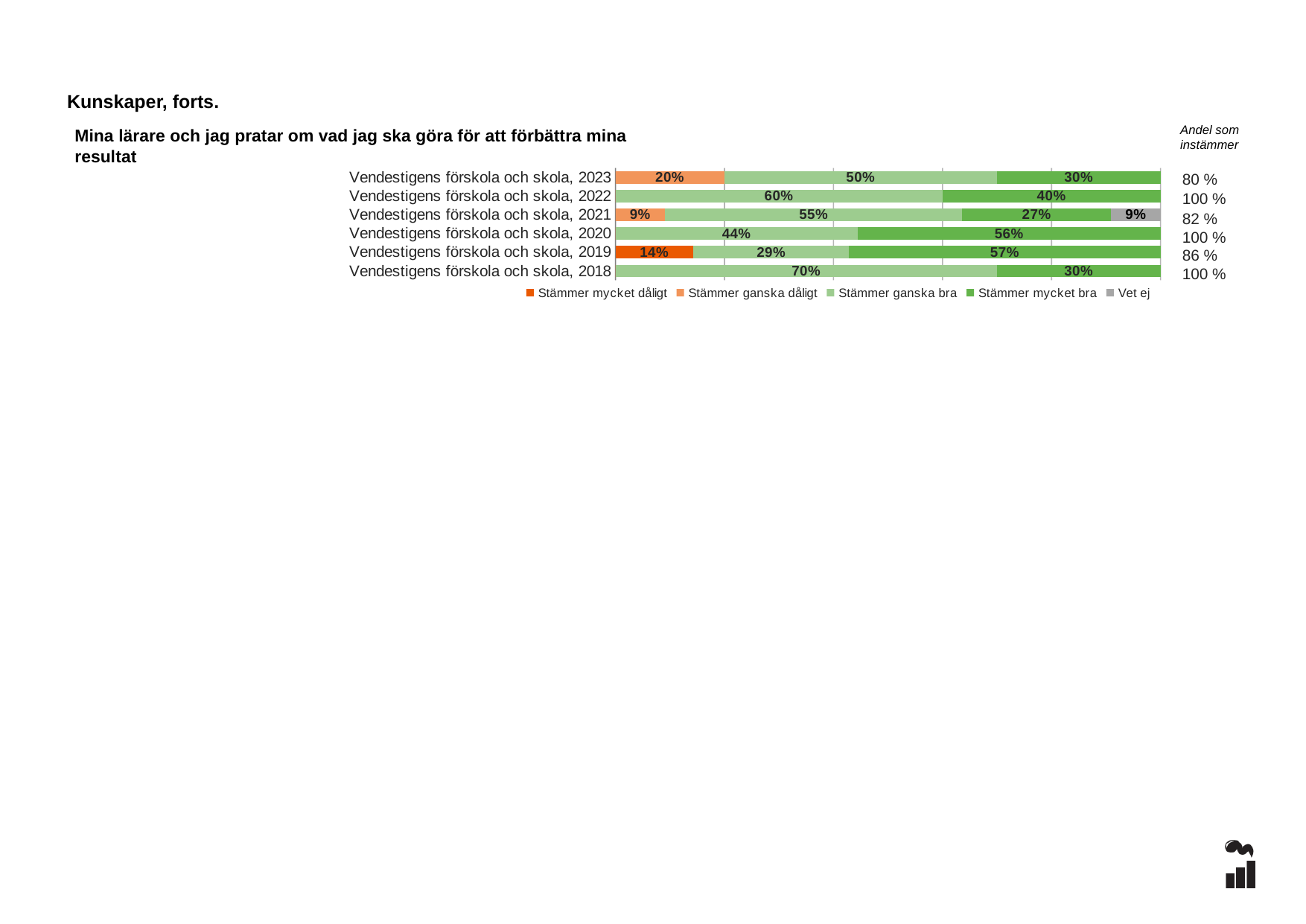
What is the value of 'Vet ej' for Vendestigens förskola och skola, 2021? 9% How many bars (categories) are plotted in the chart? 6 Which year has the lowest 'Stämmer mycket bra' value? Vendestigens förskola och skola, 2021 Which year has the highest 'Stämmer ganska bra' value? Vendestigens förskola och skola, 2018 What is the difference between the 'Stämmer mycket bra' values for 2019 and 2022? 17% What is the value of 'Stämmer ganska bra' for Vendestigens förskola och skola, 2023? 50% How many series does the legend list? 5 What is the value of 'Stämmer mycket bra' for Vendestigens förskola och skola, 2020? 56% Which is larger: 'Stämmer ganska bra' for 2022 or 'Stämmer ganska bra' for 2020? 2022 What kind of chart is shown on the slide? Stacked bar chart What is the value of 'Stämmer mycket dåligt' for Vendestigens förskola och skola, 2019? 14% What is the 'Andel som instämmer' value shown for Vendestigens förskola och skola, 2021? 82 %